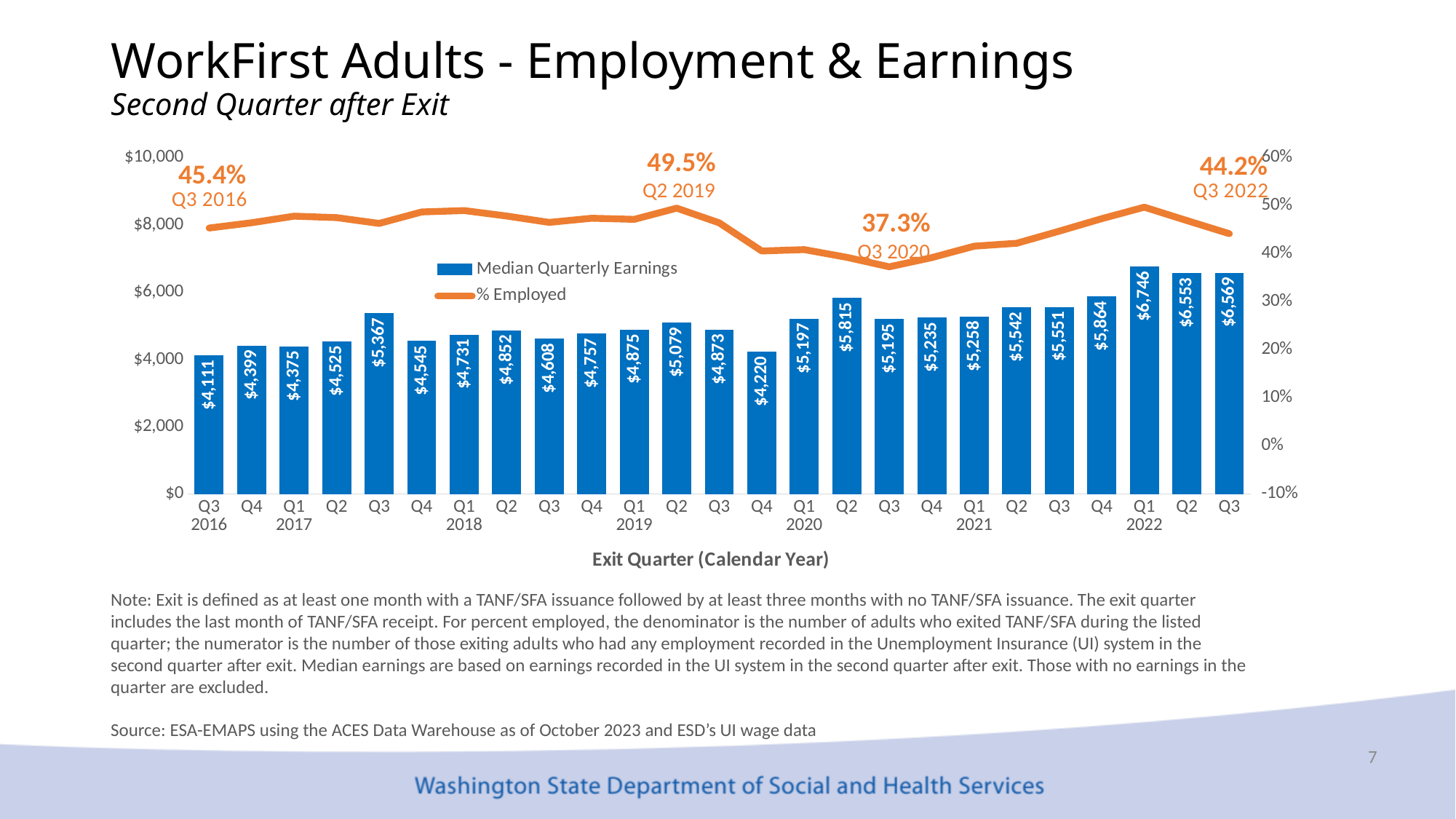
What is the median quarterly earnings value for Q4 2019? $4,220 Is the % Employed value for Q1 2017 greater or less than 40%? greater Which exit quarter has the lowest median quarterly earnings? Q3 2016 Which has higher median quarterly earnings, Q2 2020 or Q4 2021? Q4 2021 What percent employed is labeled for Q3 2020? 37.3% What is the median quarterly earnings value for Q3 2017? $5,367 How many exit quarters are shown on the x axis? 25 What kind of chart is shown on the slide? Combined bar and line chart How many series does the legend list? 2 What percent employed is labeled for Q2 2019? 49.5% What is the difference in median quarterly earnings between Q1 2022 and Q3 2016? $2,635 Which exit quarter has the highest median quarterly earnings? Q1 2022